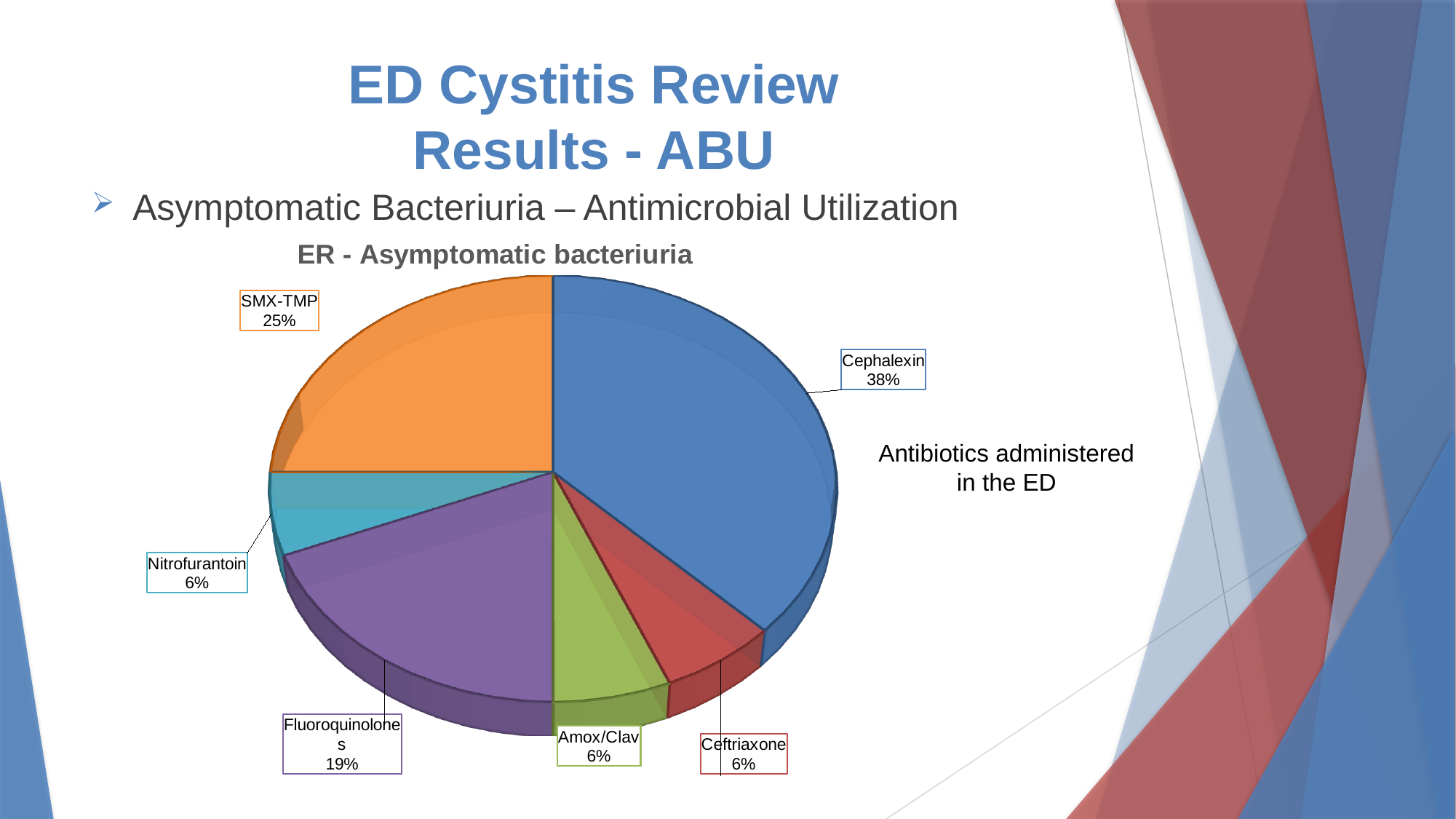
What percentage is shown for Fluoroquinolones? 19% What colour is the Ceftriaxone slice? Red What is the title of the chart? ER - Asymptomatic bacteriuria Which is larger, the share for SMX-TMP or the share for Fluoroquinolones? SMX-TMP Which antibiotic has the largest slice of the pie? Cephalexin What is the difference between the SMX-TMP and Fluoroquinolones percentages? 6% What kind of chart is shown on the slide? Pie chart What is the value shown for SMX-TMP? 25% What is the difference between the Cephalexin and SMX-TMP percentages? 13% What is the value shown for Nitrofurantoin? 6% How many antibiotic categories are shown in the pie chart? 6 What share of the pie does Cephalexin represent? 38%